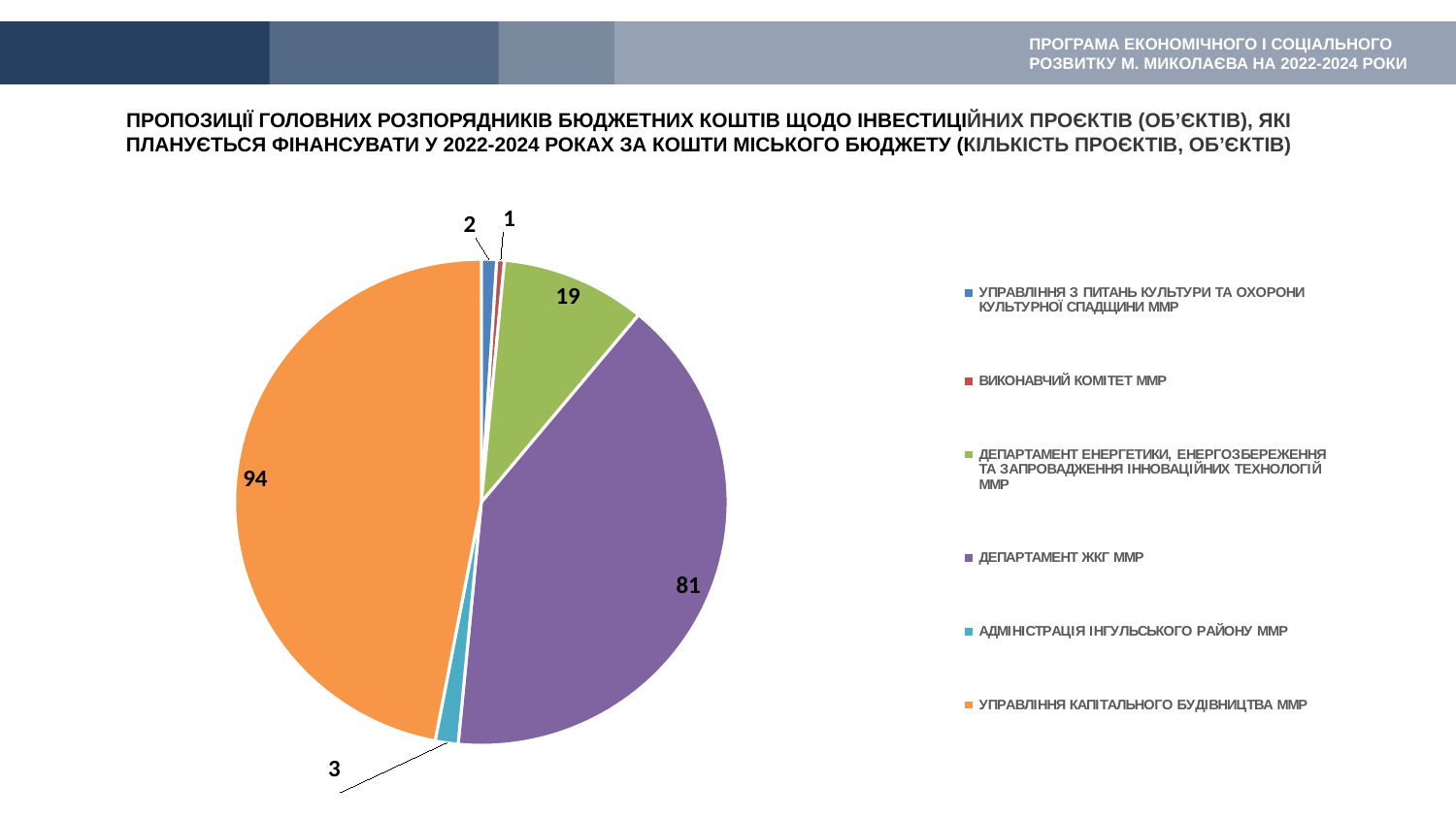
What is the difference between the values for Управління капітального будівництва ММР and Департамент ЖКГ ММР? 13 What is the value for Адміністрація Інгульського району ММР? 3 What type of chart is shown on the slide? pie chart What is the value for Управління капітального будівництва ММР? 94 What share of the pie does Управління капітального будівництва ММР represent? 47% What is the value for Департамент енергетики, енергозбереження та запровадження інноваційних технологій ММР? 19 Which category has the largest slice of the pie? Управління капітального будівництва ММР What is the value for Департамент ЖКГ ММР? 81 How many slices does the pie chart have? 6 How many entries does the legend list? 6 Which is larger: the value for Управління з питань культури та охорони культурної спадщини ММР or the value for Адміністрація Інгульського району ММР? Адміністрація Інгульського району ММР Which category has the smallest slice of the pie? Виконавчий комітет ММР